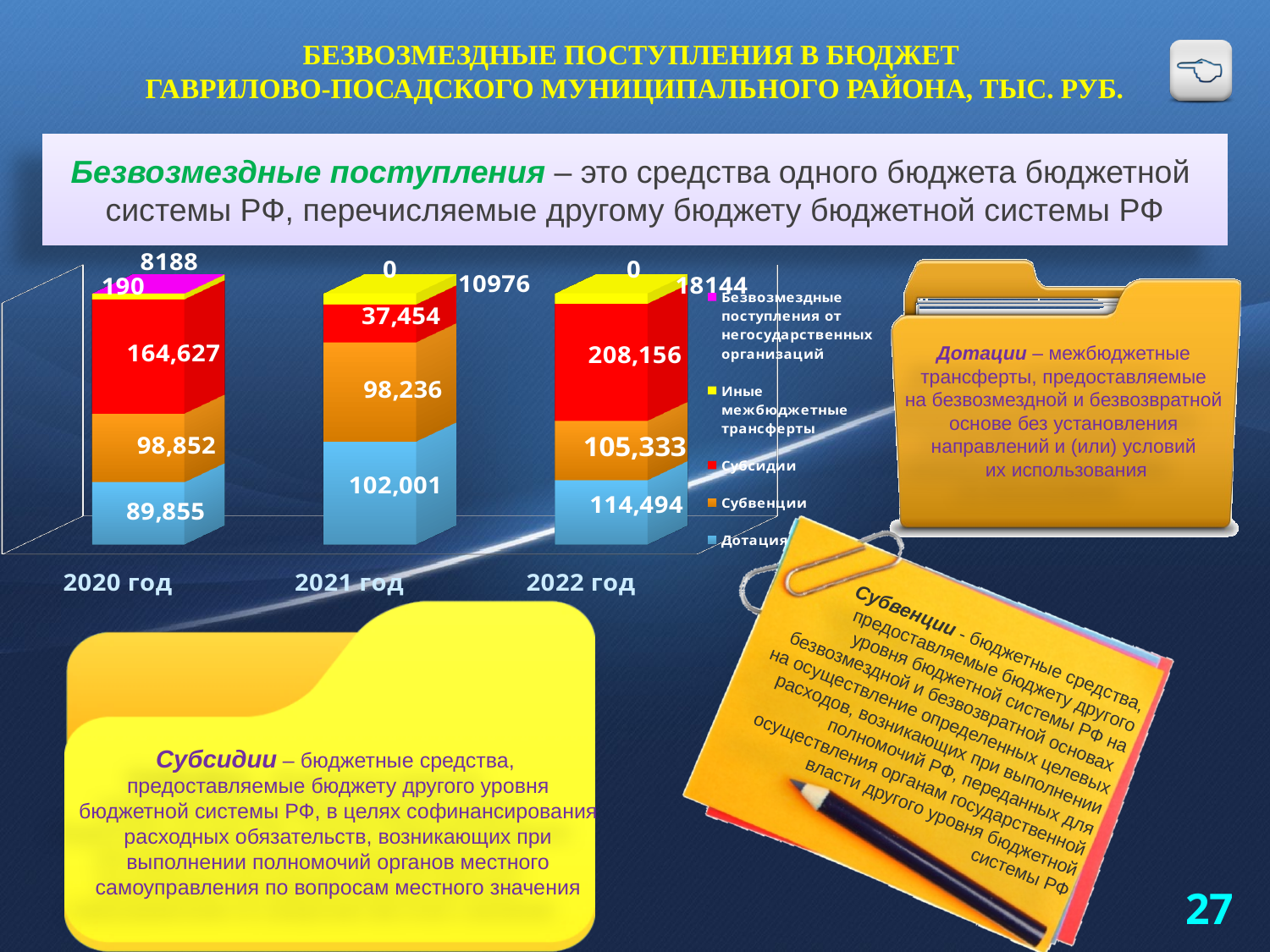
What is the value of Субсидии for 2022 год? 208,156 Does the Дотация value rise or fall from 2020 год to 2022 год? Rise What kind of chart is shown on the slide? Stacked bar chart In which year is the Субсидии value the lowest? 2021 год What is the value of Субвенции for 2021 год? 98,236 Which is larger for 2021 год: Дотация or Субвенции? Дотация In which year is the Дотация value the highest? 2022 год What is the difference between the Дотация values for 2022 год and 2020 год? 24,639 What is the value of Иные межбюджетные трансферты for 2022 год? 18144 What is the value of Дотация for 2020 год? 89,855 How many series does the chart legend list? 5 How many years are shown on the x axis of the chart? 3